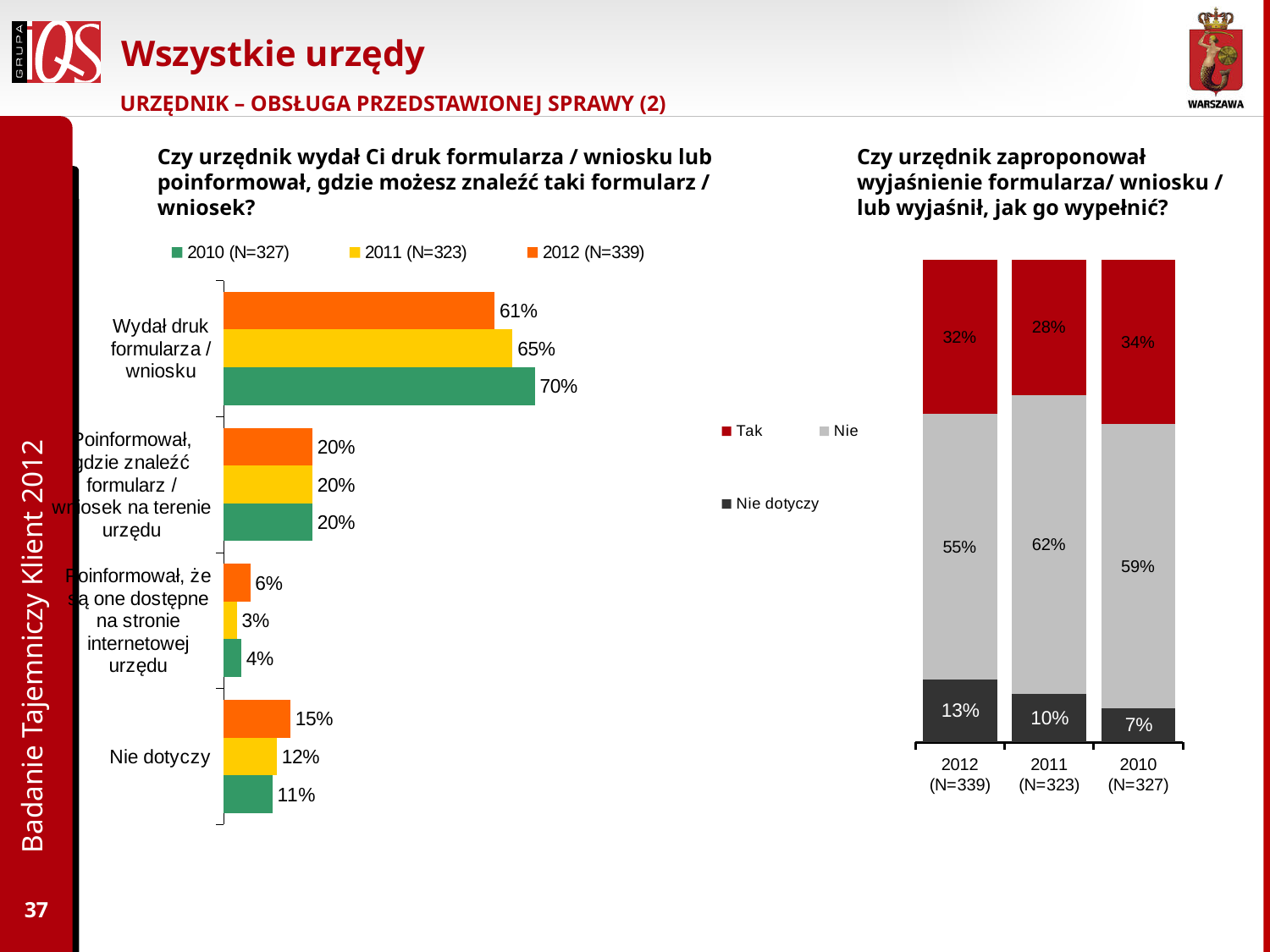
In the left chart, what is the difference between the 2010 and 2012 values for "Wydał druk formularza / wniosku"? 9 percentage points In the left chart, what is the 2012 value for "Nie dotyczy"? 15% In the right chart, is the "Tak" value for 2012 larger or smaller than the "Tak" value for 2011? Larger What type of chart is the left chart? Bar chart In the left chart, which category has the highest value for 2012? Wydał druk formularza / wniosku In the right chart, what is the "Nie dotyczy" value for 2010 (N=327)? 7% In the left chart, what is the 2011 value for "Poinformował, że są one dostępne na stronie internetowej urzędu"? 3% In the left chart, how many series does the legend list? 3 In the right chart, how many bars are shown? 3 In the right chart, which year has the highest "Tak" value? 2010 (N=327) In the right chart, what is the "Nie" value for 2011 (N=323)? 62% In the left chart, what is the 2010 value for "Wydał druk formularza / wniosku"? 70%